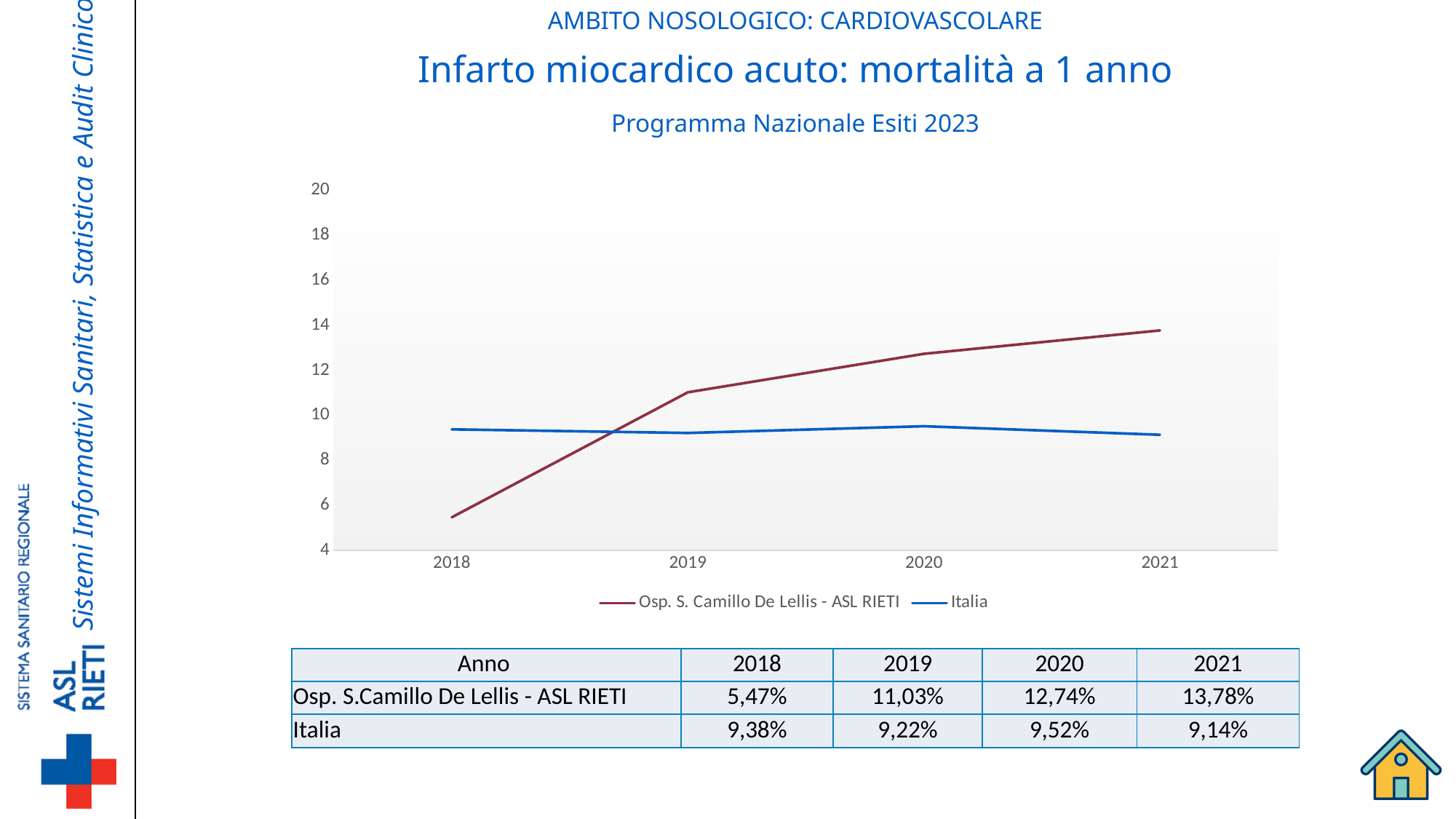
What kind of chart is shown on the slide? line chart What is the value for Italia in 2020? 9,52% Which colour is used for the Italia line in the chart? blue How many series does the chart legend list? 2 In which year is the value for Italia lowest? 2021 In 2018, which series has the larger value, Osp. S. Camillo De Lellis - ASL RIETI or Italia? Italia In which year is the value for Osp. S. Camillo De Lellis - ASL RIETI highest? 2021 What is the value for Osp. S. Camillo De Lellis - ASL RIETI in 2018? 5,47% Does the Osp. S. Camillo De Lellis - ASL RIETI line rise or fall from 2018 to 2021? rise What is the difference between the Osp. S. Camillo De Lellis - ASL RIETI value and the Italia value in 2021? 4,64% How many years are plotted along the x axis of the chart? 4 What is the value for Osp. S. Camillo De Lellis - ASL RIETI in 2021? 13,78%